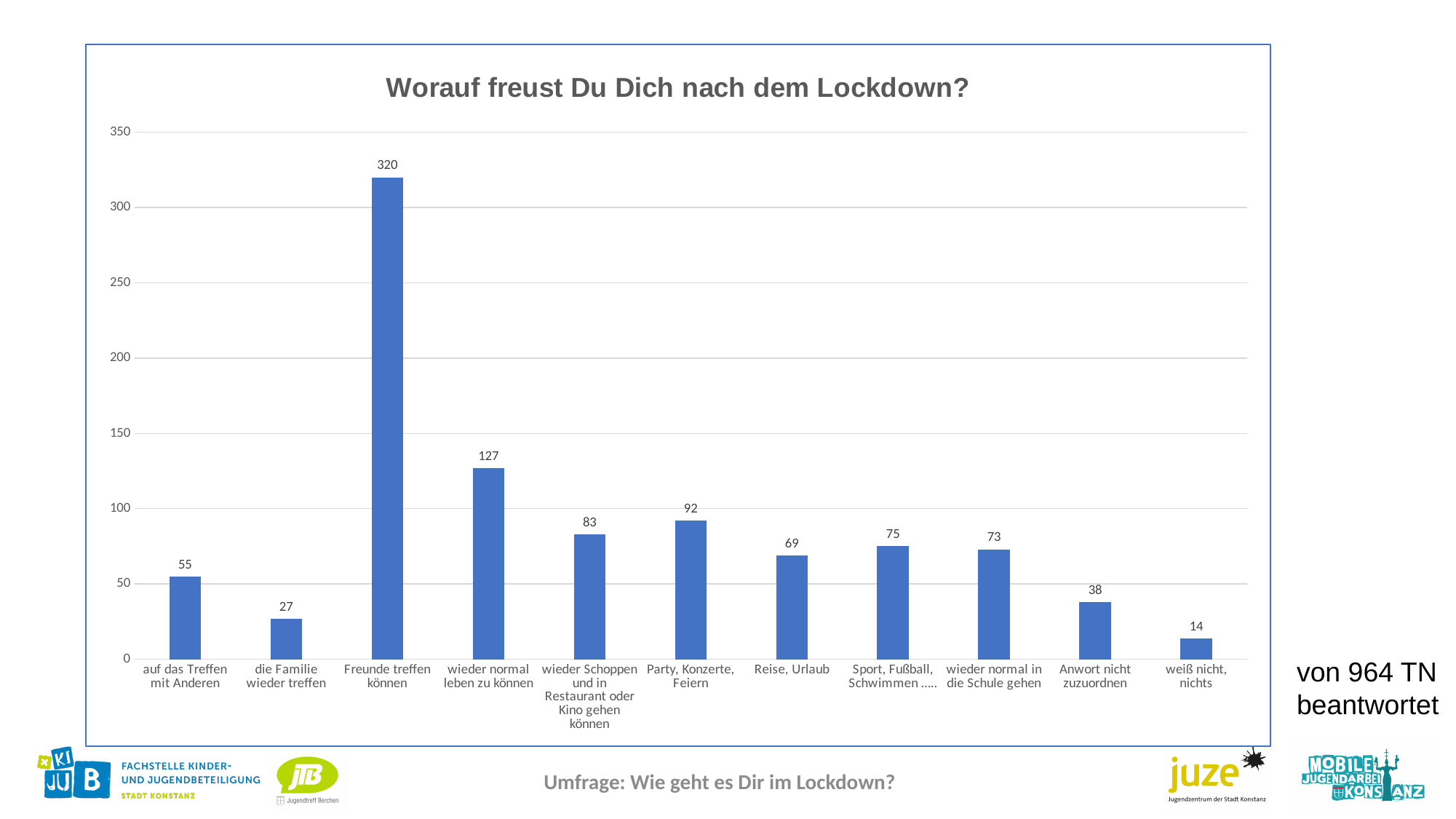
What is the value for "Freunde treffen können"? 320 Is the value for "wieder Schoppen und in Restaurant oder Kino gehen können" greater or less than 100? less What is the difference between the values for "Freunde treffen können" and "wieder normal leben zu können"? 193 Which category has the lowest value? weiß nicht, nichts What is the title of the chart? Worauf freust Du Dich nach dem Lockdown? Which category has the highest value? Freunde treffen können What is the value for "Anwort nicht zuzuordnen"? 38 What is the value for "Party, Konzerte, Feiern"? 92 What kind of chart is shown on the slide? bar chart What is the difference between the values for "Sport, Fußball, Schwimmen ....." and "Reise, Urlaub"? 6 Which is larger, the value for "auf das Treffen mit Anderen" or the value for "die Familie wieder treffen"? auf das Treffen mit Anderen How many categories are shown on the x axis? 11